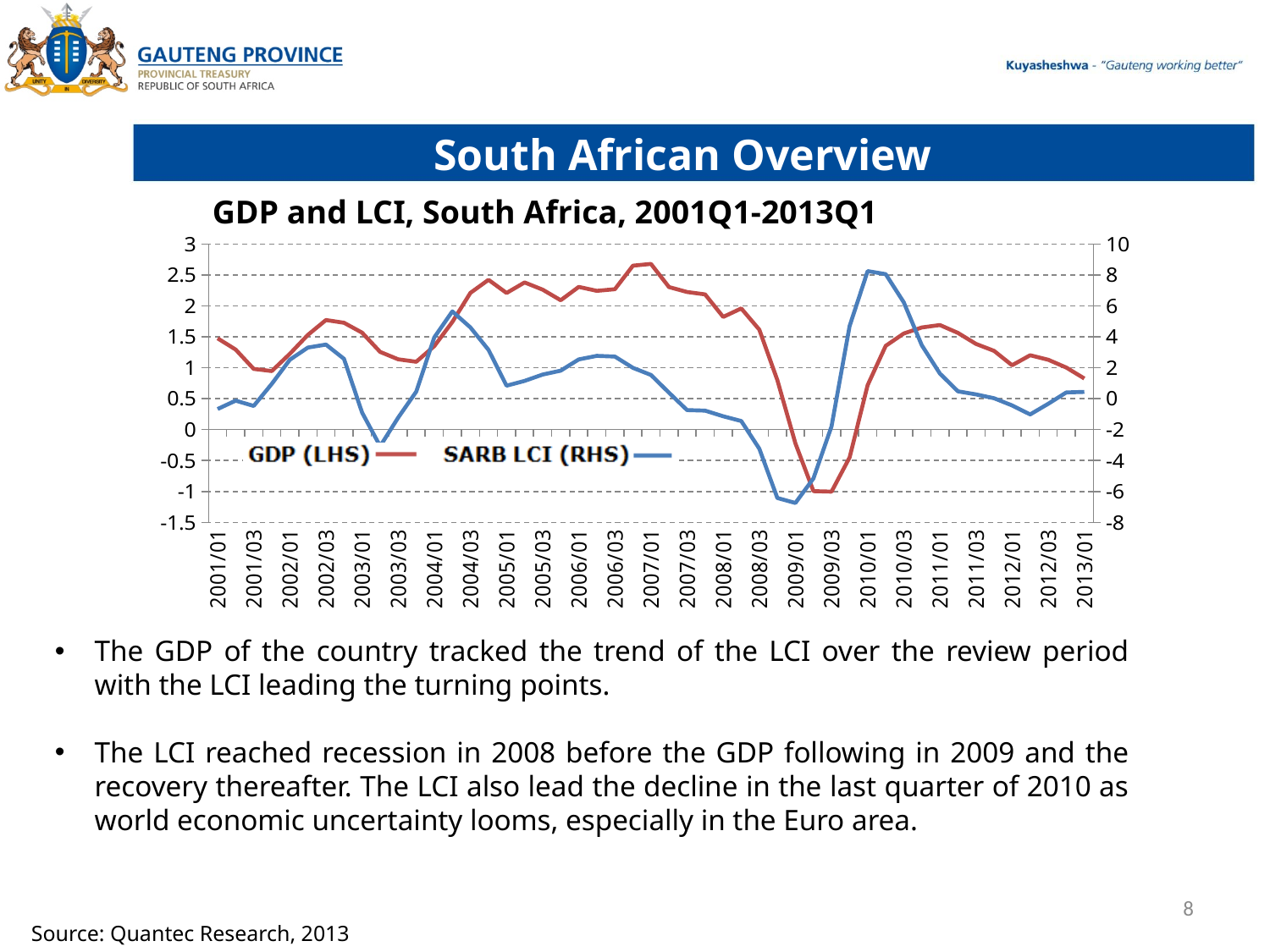
What is the title of the chart? GDP and LCI, South Africa, 2001Q1-2013Q1 What kind of chart is shown on the slide? Line chart Is the GDP (LHS) value at 2007/01 greater or less than 2? greater Around which quarter does the GDP (LHS) series reach its lowest point? 2009/03 Does the GDP (LHS) series rise or fall between 2007/01 and 2009/03? fall Is the GDP (LHS) value at 2009/03 greater or less than 0? less How many series does the chart's legend list? 2 Which series is plotted against the right-hand axis? SARB LCI (RHS) Is the SARB LCI (RHS) value at 2010/01 greater or less than 6? greater Around which quarter does the SARB LCI (RHS) series reach its highest point? 2010/01